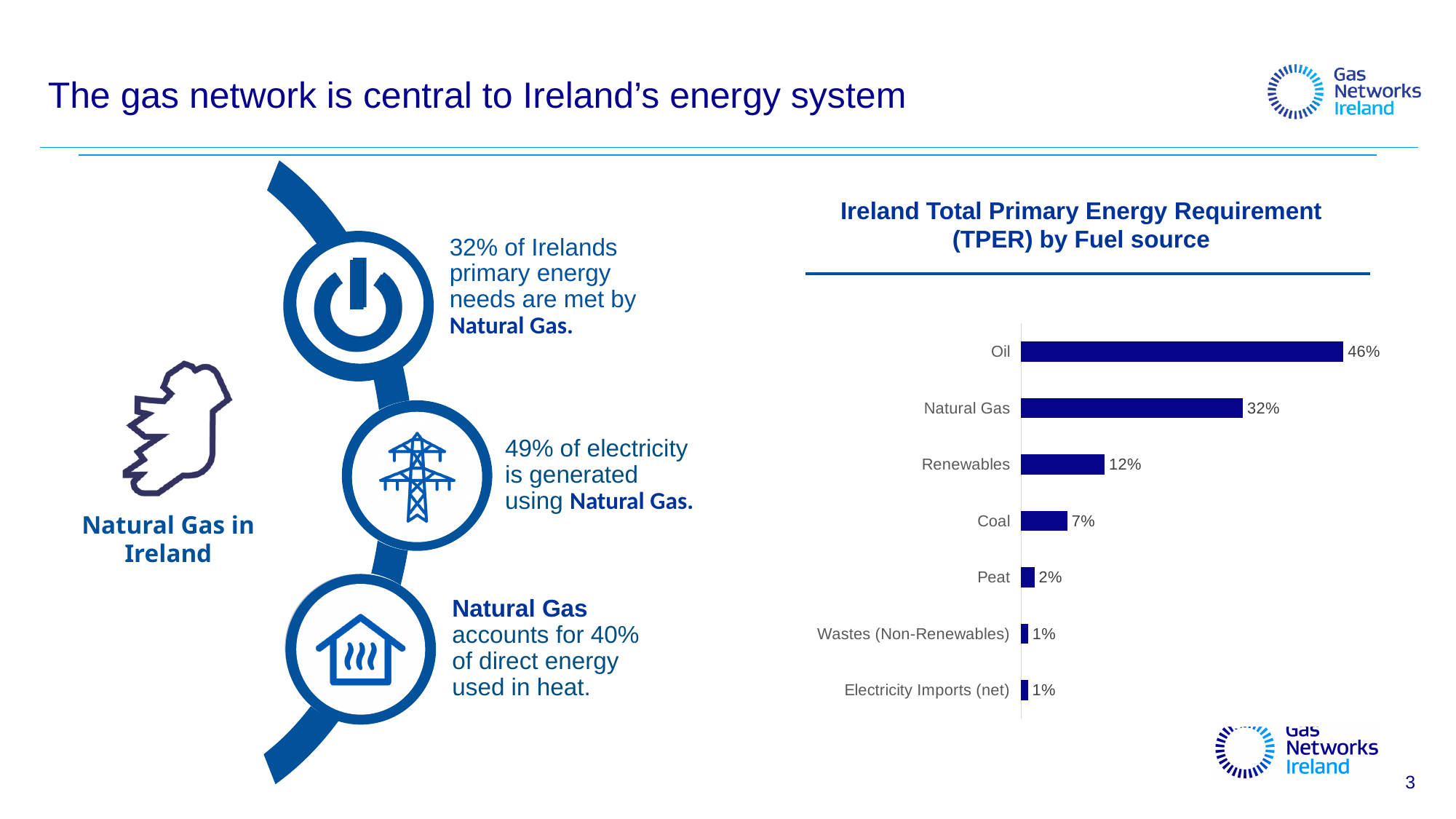
What is the title of the chart on the slide? Ireland Total Primary Energy Requirement (TPER) by Fuel source What is the difference between the values for Renewables and Coal in the chart? 5% What share of Ireland's Total Primary Energy Requirement comes from Natural Gas according to the chart? 32% What is the value for Oil in the Ireland Total Primary Energy Requirement chart? 46% What kind of chart is used to show Ireland's Total Primary Energy Requirement by fuel source? Bar chart How many fuel source categories are shown in the chart? 7 What is the difference between the values for Oil and Natural Gas in the chart? 14% Which fuel source has the highest value in the chart? Oil What is the value shown for Peat in the chart? 2% What is the value shown for Coal in the chart? 7% What is the value shown for Renewables in the chart? 12% Which has a larger value in the chart, Coal or Peat? Coal